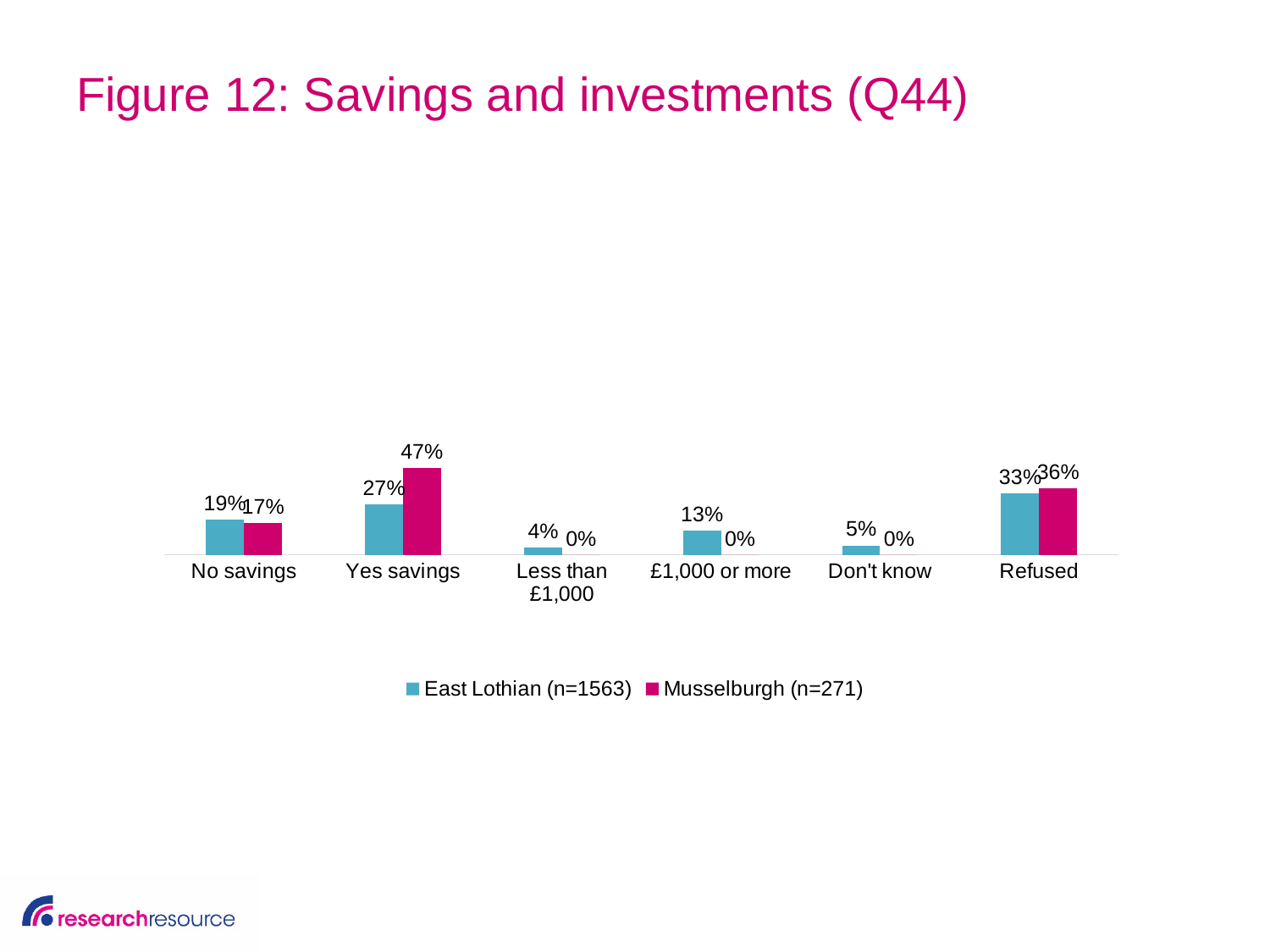
Which category has the lowest value for East Lothian? Less than £1,000 What is the value for Musselburgh in the 'Refused' category? 36% What is the sample size for Musselburgh shown in the legend? n=271 What is the value for East Lothian in the '£1,000 or more' category? 13% How many categories are shown on the x axis? 6 Which category has the highest value for Musselburgh? Yes savings How many series does the legend list? 2 What is the value for East Lothian in the 'Yes savings' category? 27% What kind of chart is shown on the slide? Bar chart What is the value for Musselburgh in the 'Yes savings' category? 47% Which is larger in the 'No savings' category: East Lothian or Musselburgh? East Lothian What is the difference between Musselburgh and East Lothian in the 'Yes savings' category? 20%